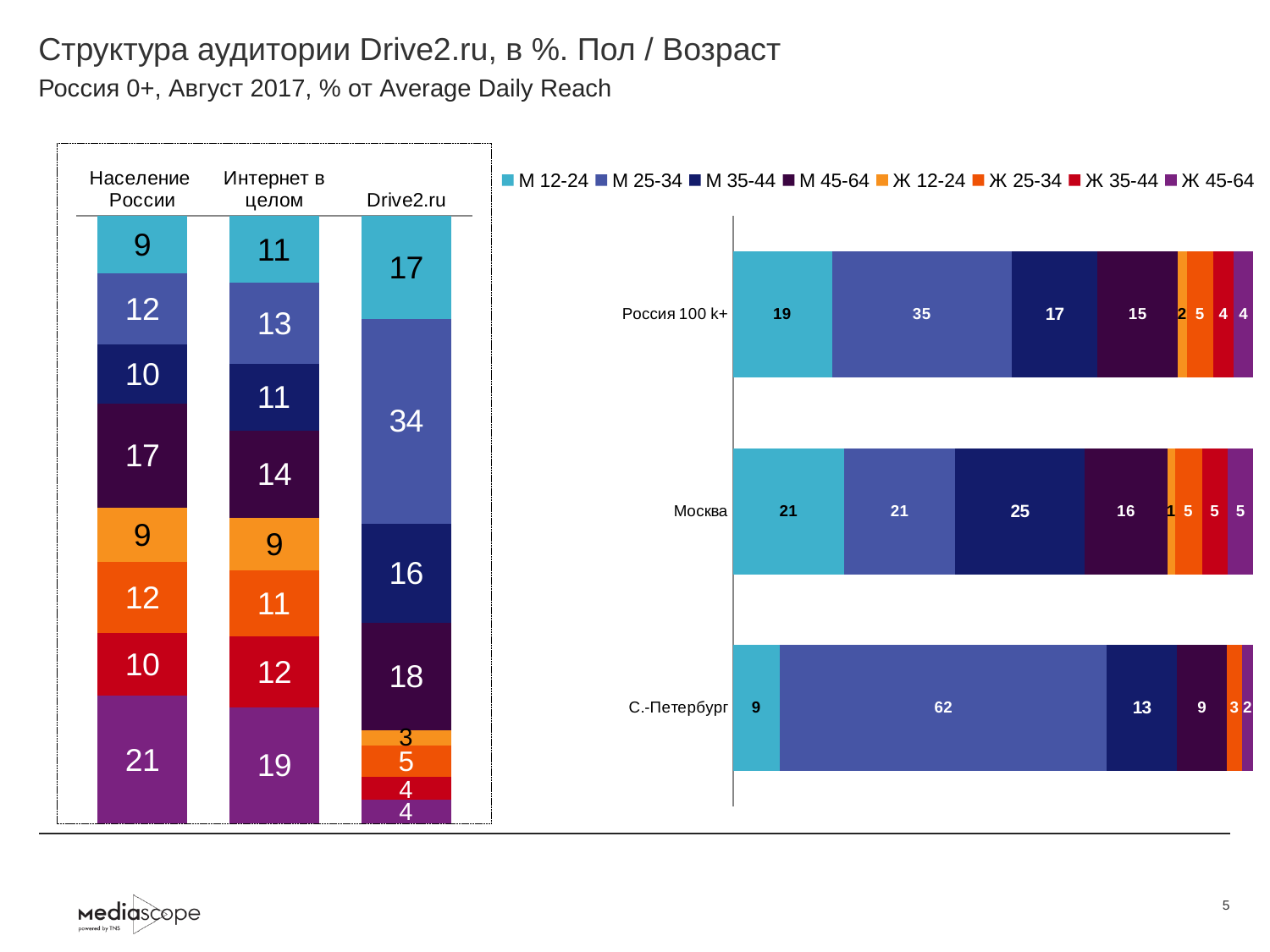
In the right chart, what is the difference between the М 12-24 values for Москва and Россия 100 k+? 2 In the right chart, which bar has the highest value for М 25-34? С.-Петербург In the left chart, what is the value of the Ж 45-64 (bottom) segment in the Население России bar? 21 In the left chart, which bar has the larger М 45-64 segment: Drive2.ru or Интернет в целом? Drive2.ru In the left chart, what is the total of the Население России stacked bar? 100 How many series does the legend list? 8 In the right chart, what is the value for М 25-34 in the С.-Петербург bar? 62 What kind of chart is the right chart? Stacked bar chart In the right chart, what is the value for М 35-44 in the Москва bar? 25 In the left chart, what is the value of the М 25-34 segment in the Drive2.ru bar? 34 In the right chart, what is the value for М 25-34 in the Россия 100 k+ bar? 35 How many bars (categories) are shown in the right chart? 3